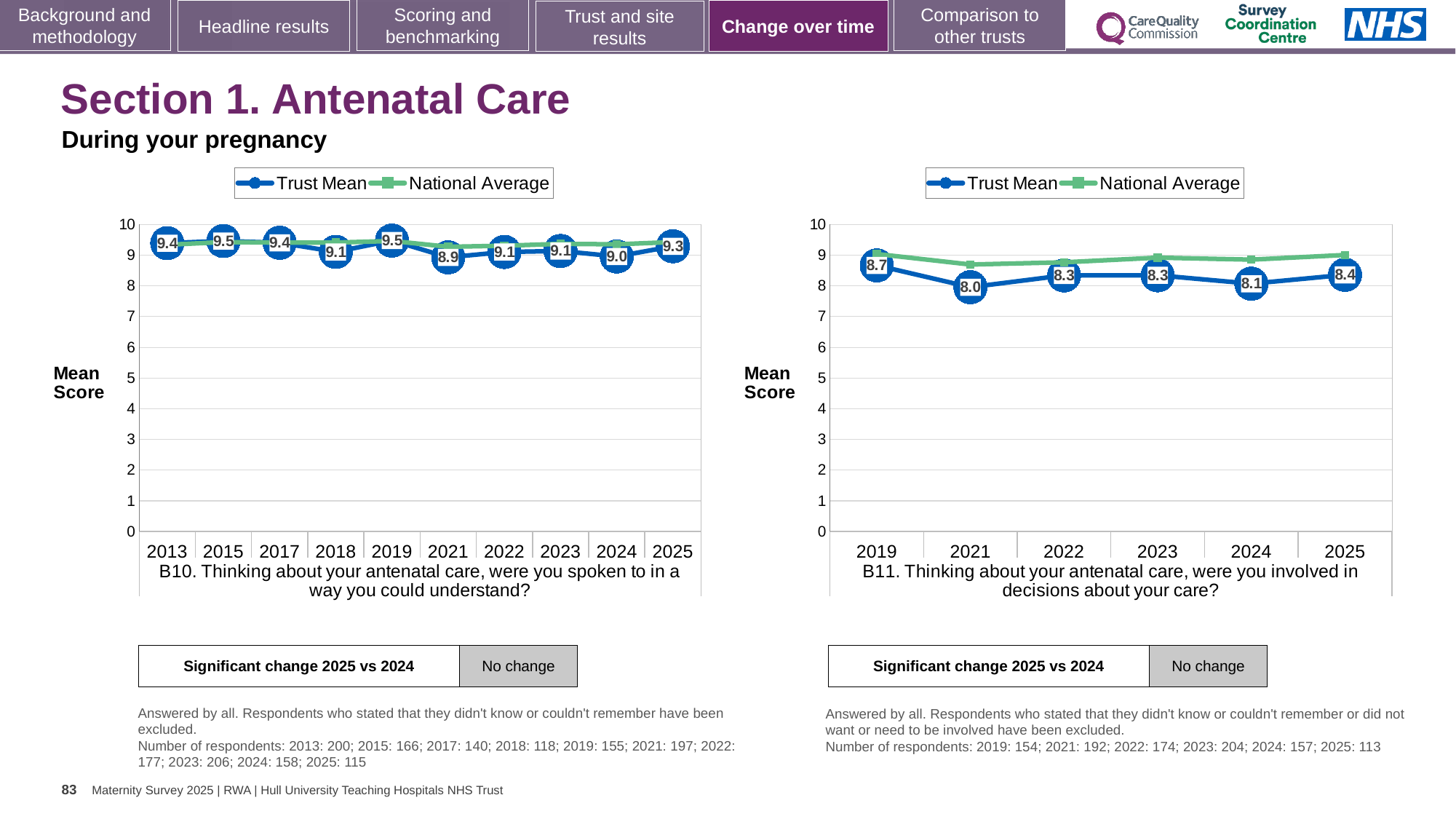
In the B10 chart on the left, what is the Trust Mean score for 2025? 9.3 In the B10 chart on the left, what is the difference between the Trust Mean scores for 2025 and 2024? 0.3 In the B11 chart on the right, what is the Trust Mean score for 2019? 8.7 In the B10 chart on the left, what is the Trust Mean score for 2021? 8.9 In the B11 chart on the right, is the National Average value for 2021 greater or less than 8? greater In the B11 chart on the right, which year has the highest Trust Mean score? 2019 How many series does the legend of the B11 chart on the right list? 2 In the B11 chart on the right, which year has the lowest Trust Mean score? 2021 In the B10 chart on the left, which year has the lowest Trust Mean score? 2021 In the B10 chart on the left, how many years are shown on the x axis? 10 What kind of chart is the B10 chart on the left? line chart In the B11 chart on the right, is the Trust Mean score for 2025 larger or smaller than the score for 2024? larger